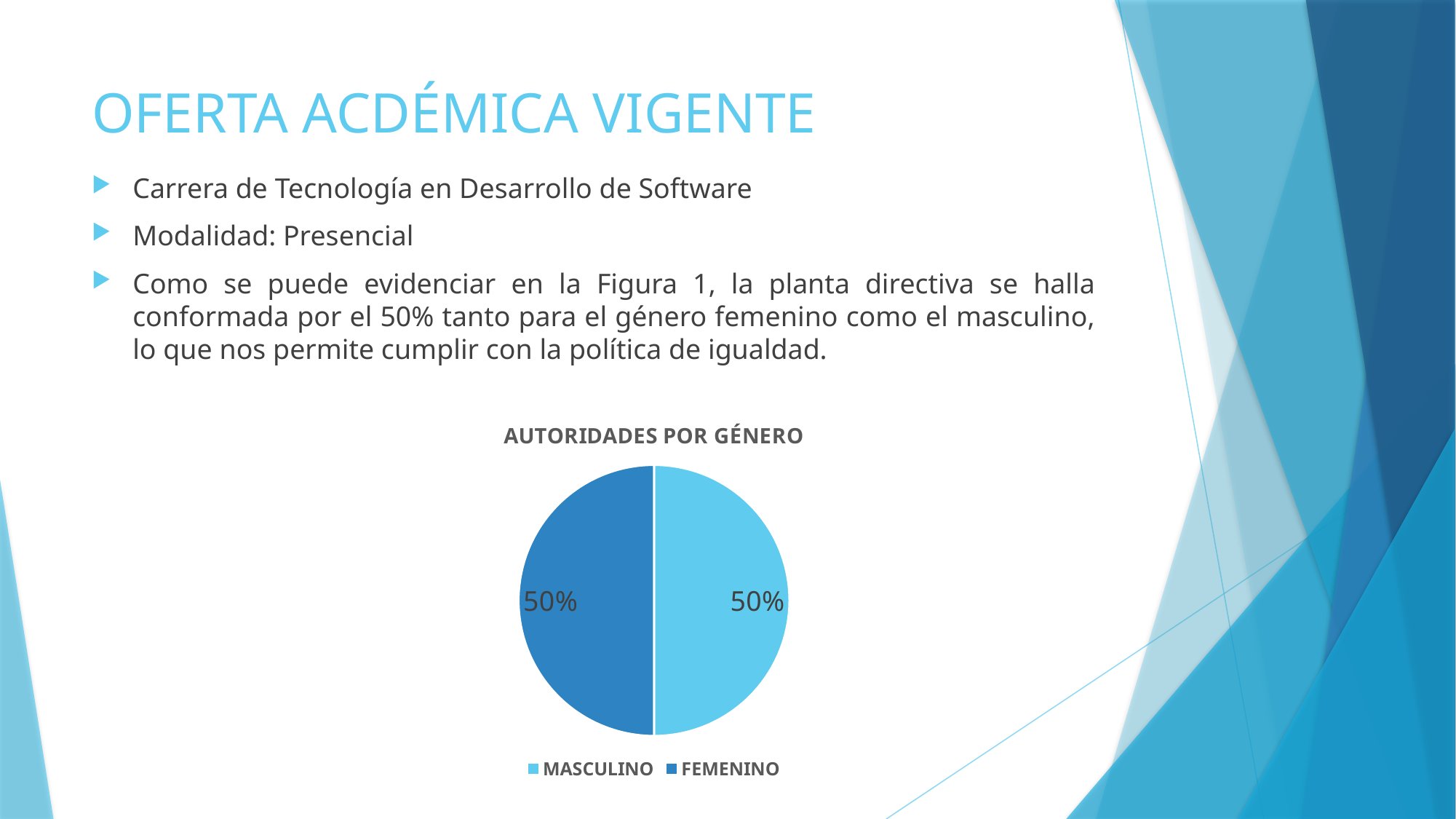
Which legend entry is shown in the darker blue colour? FEMENINO How many entries does the legend list? 2 What is the total of the two slices shown in the pie chart? 100% What share of the pie does FEMENINO represent? 50% What share of the pie does MASCULINO represent? 50% How many slices does the pie chart have? 2 What is the title of the chart? AUTORIDADES POR GÉNERO What kind of chart is shown on the slide? pie chart What is the difference between the MASCULINO and FEMENINO shares? 0%